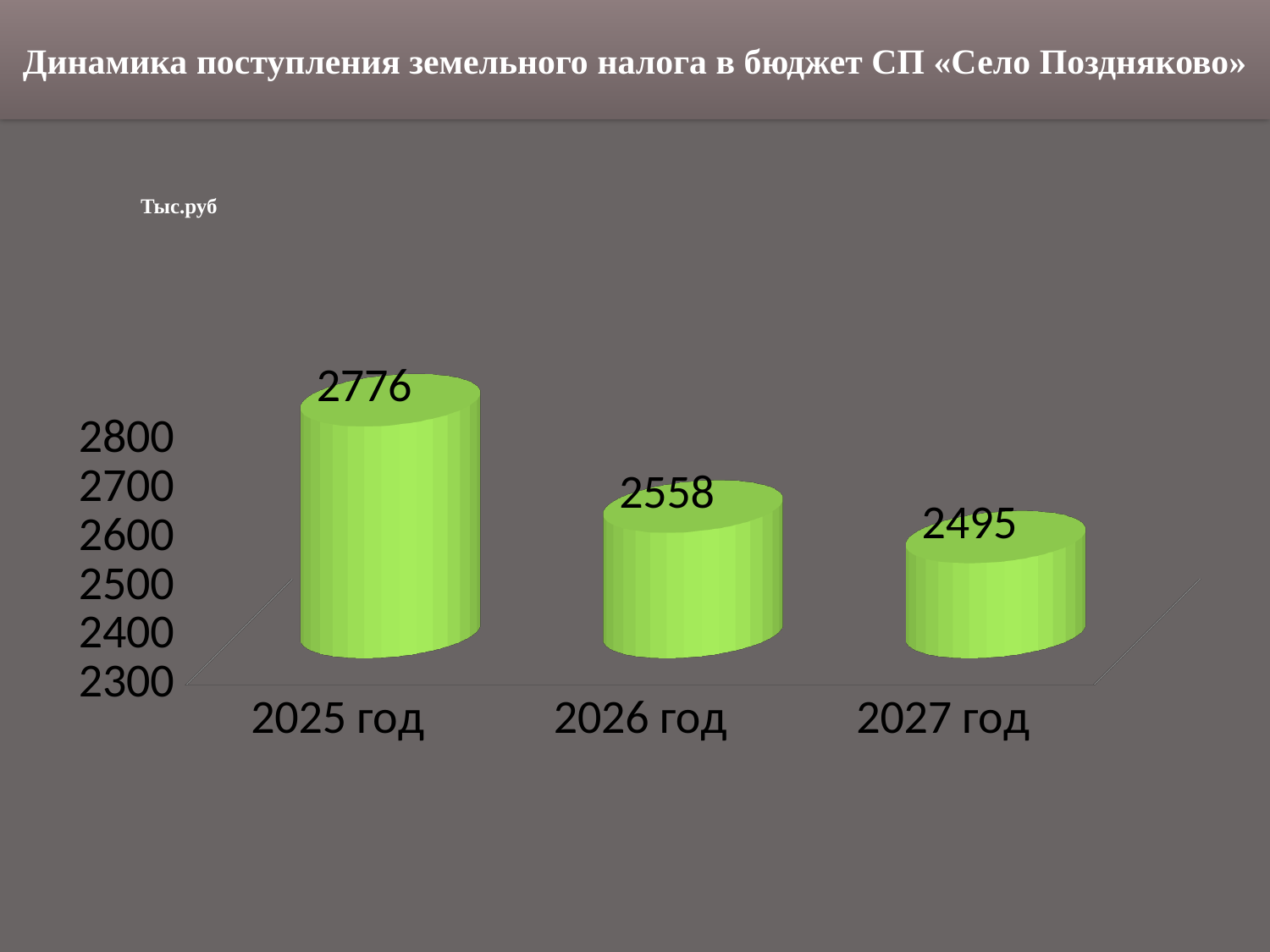
How many years are shown on the chart? 3 What kind of chart is shown on the slide? bar chart Do the values rise or fall from 2025 год to 2027 год? fall What is the difference between the values for 2026 год and 2027 год? 63 Is the value for 2026 год greater or less than 2600? less What is the value for 2025 год? 2776 What is the difference between the values for 2025 год and 2026 год? 218 What is the value for 2027 год? 2495 Which year has the lowest value? 2027 год Which is larger, the value for 2025 год or the value for 2027 год? 2025 год What is the value for 2026 год? 2558 Which year has the highest value? 2025 год